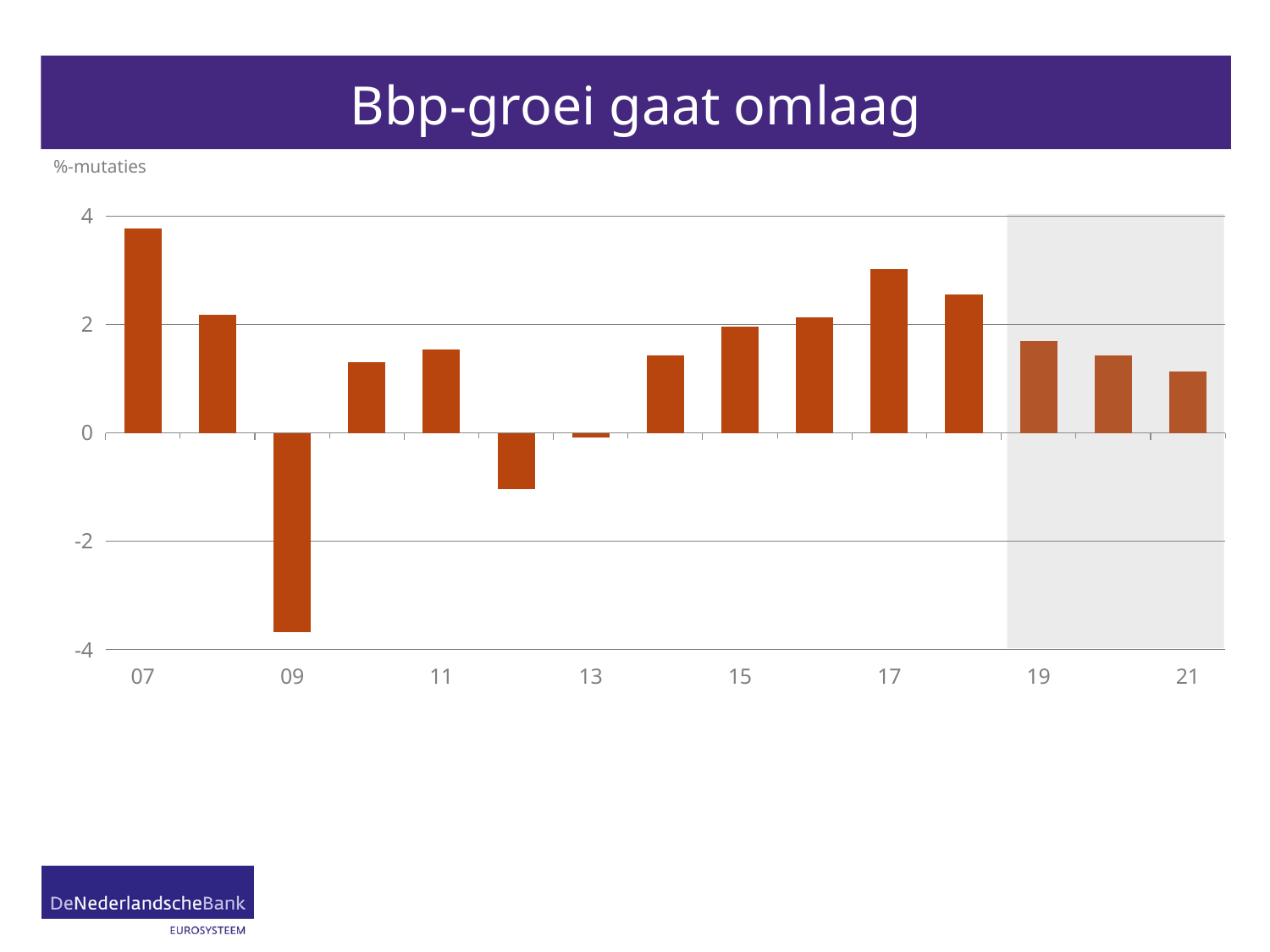
How many bars (years) are plotted in the chart? 15 Which year has the lowest value in the chart? 09 Do the values rise or fall from 19 to 21? fall Which is larger, the value for 18 or the value for 21? 18 Which year has the highest value in the chart? 07 Is the value for 17 greater or less than 2? greater What unit label is shown above the chart's y axis? %-mutaties What kind of chart is shown on the slide? bar chart Is the value for 19 greater or less than 2? less Which is larger, the value for 07 or the value for 17? 07 Is the value for 09 greater or less than -2? less What is the title of the chart? Bbp-groei gaat omlaag